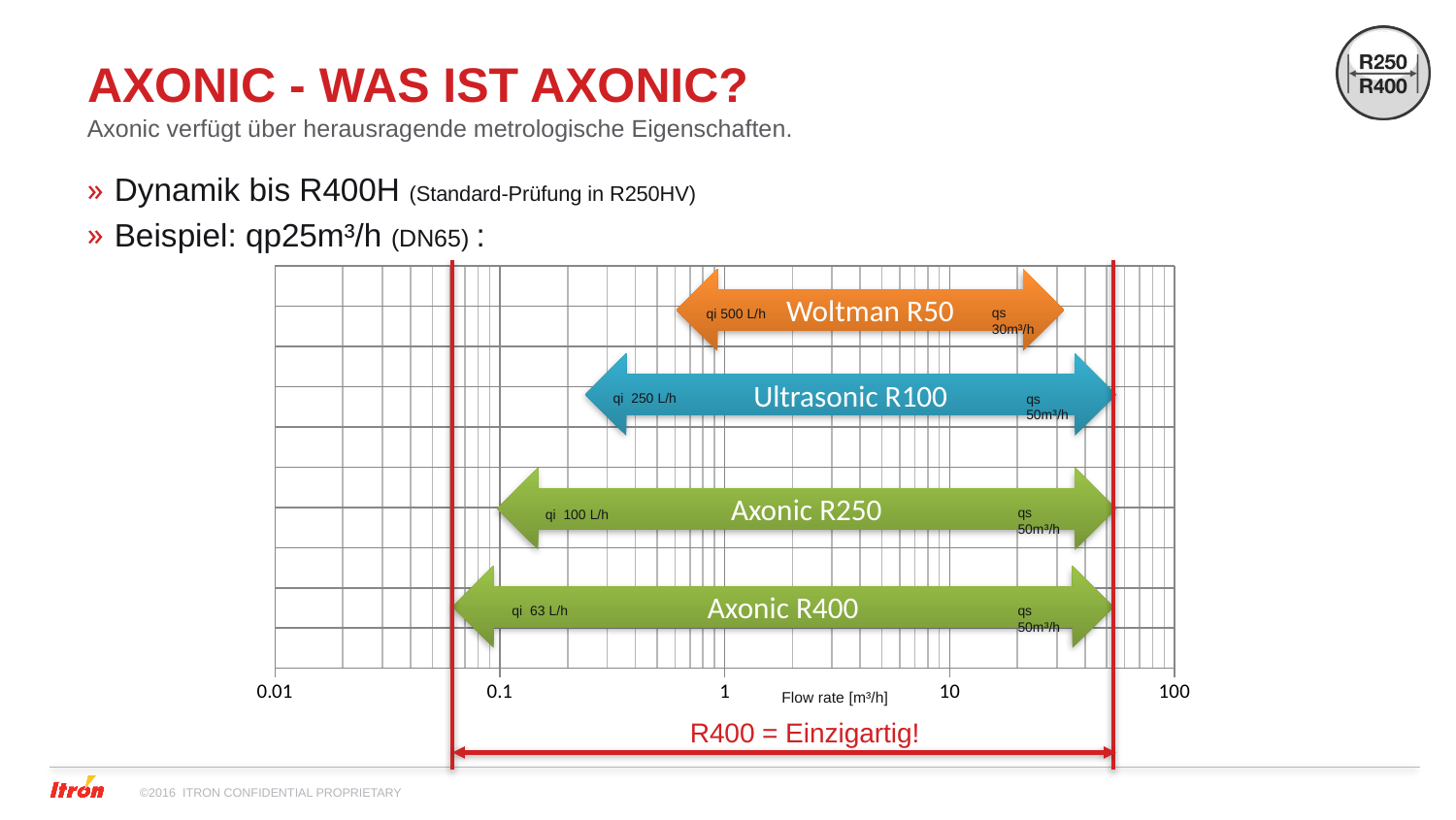
What is the qs value printed on the Woltman R50 arrow? 30m³/h What is the qi value printed on the Axonic R400 arrow? 63 L/h Which has the larger qi value, Axonic R250 or Axonic R400? Axonic R250 Which meter has the highest qi value? Woltman R50 What is the difference between the qi of Woltman R50 and the qi of Ultrasonic R100? 250 L/h What is the qi value printed on the Woltman R50 arrow? 500 L/h How many meter ranges (arrows) are shown in the diagram? 4 Which meter has the lowest qi value? Axonic R400 What is the label of the horizontal axis of the diagram? Flow rate [m³/h] What is the qs value printed on the Axonic R400 arrow? 50m³/h What is the qi value printed on the Ultrasonic R100 arrow? 250 L/h What is the qi value printed on the Axonic R250 arrow? 100 L/h